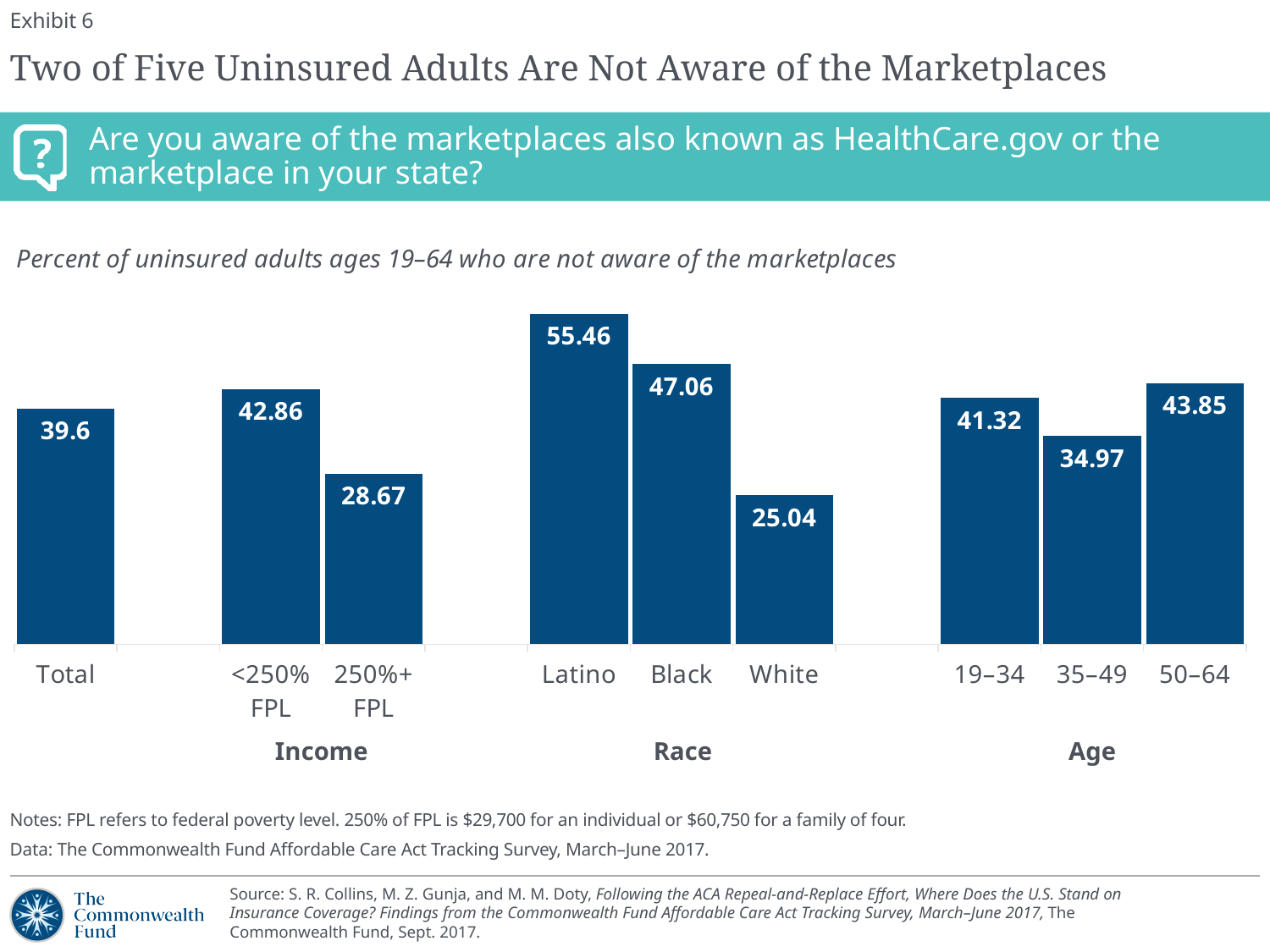
What is the difference between the values for Latino and White? 30.42 Which category has the lowest value? White Which is larger, the value for ages 19–34 or ages 50–64? 50–64 What is the value for 250%+ FPL? 28.67 What is the value for Latino? 55.46 What kind of chart is this? Bar chart What is the difference between the values for <250% FPL and 250%+ FPL? 14.19 What is the value for Total? 39.6 Which category has the highest value? Latino How many bars are shown in the chart? 9 What is the value for ages 35–49? 34.97 What are the three group labels shown beneath the category axis? Income, Race, Age